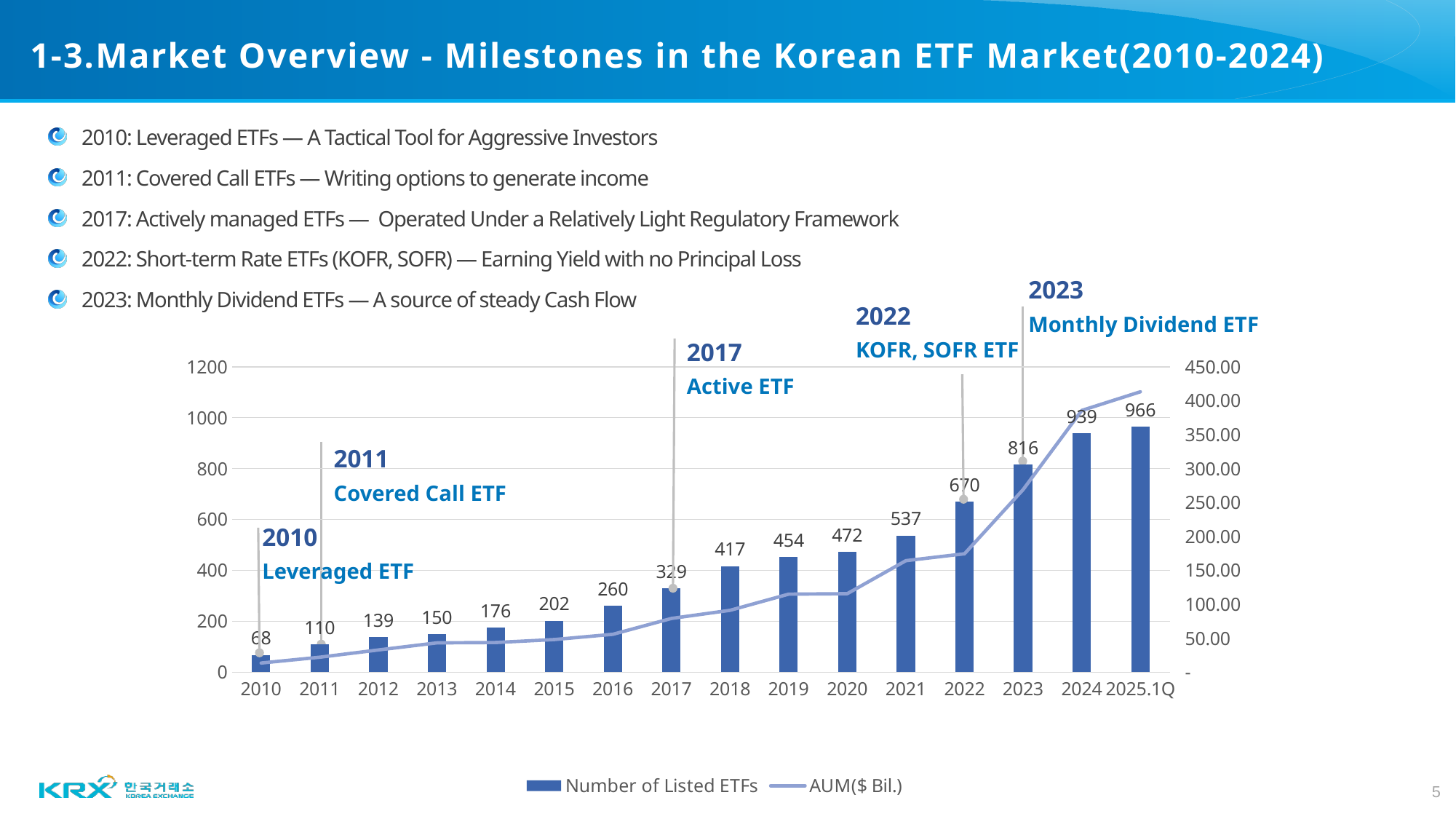
How many listed ETFs were there in 2017? 329 Does the number of listed ETFs rise or fall from 2010 to 2025.1Q? rise What is the difference in the number of listed ETFs between 2023 and 2022? 146 Which year has the lowest number of listed ETFs? 2010 How many series does the chart legend list? 2 Which period has the highest number of listed ETFs? 2025.1Q Which year has more listed ETFs, 2019 or 2021? 2021 Is the AUM($ Bil.) value for 2017 greater or less than 100.00? less Is the AUM($ Bil.) value for 2022 greater or less than 150.00? greater How many time periods are shown on the x axis of the chart? 16 What is the number of listed ETFs shown for 2010? 68 What is the number of listed ETFs shown for 2025.1Q? 966